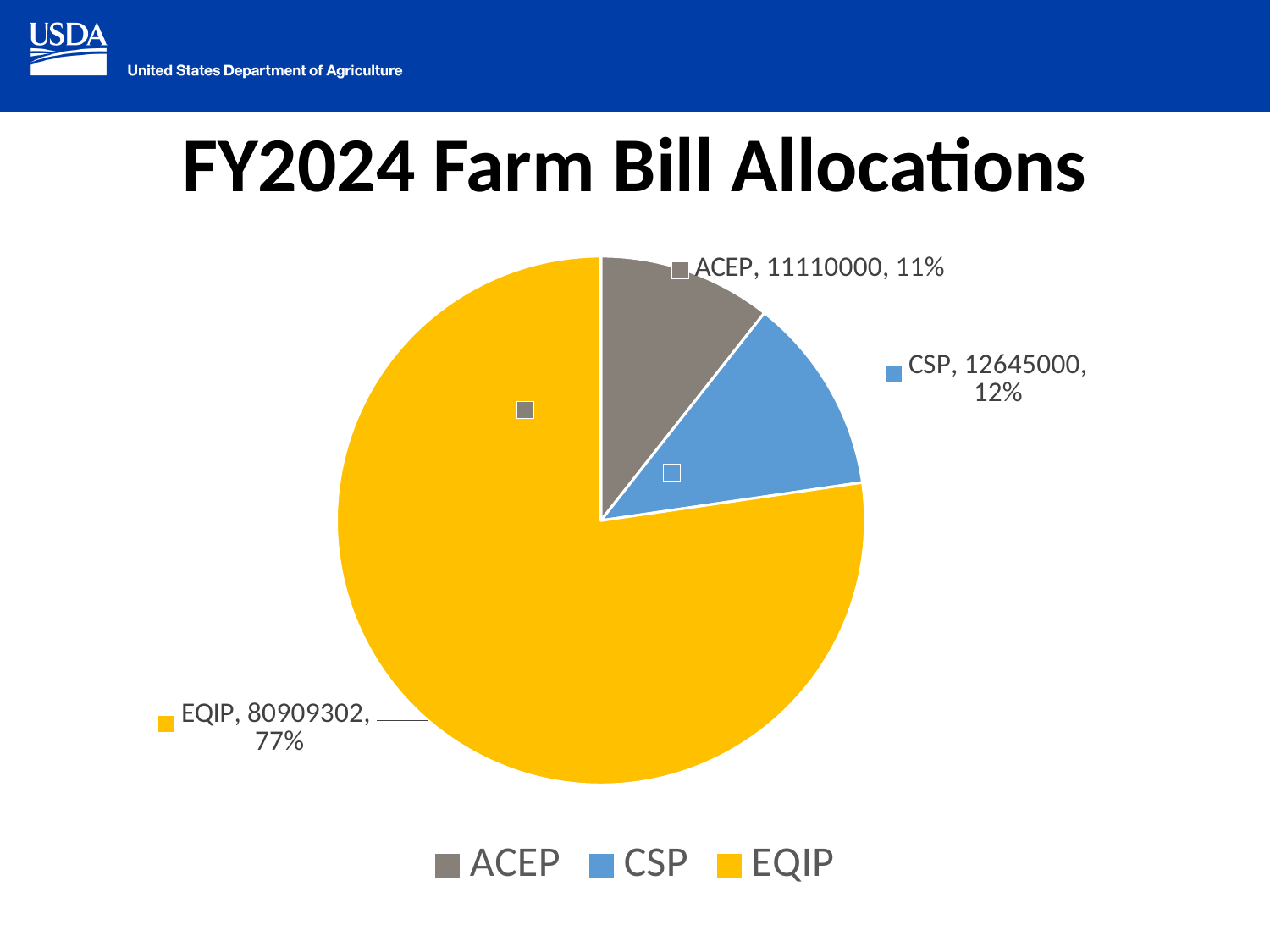
Which category has the largest slice of the pie? EQIP What is the value for ACEP? 11110000 What share of the pie does ACEP represent? 11% What type of chart is shown on the slide? Pie chart What is the value for CSP? 12645000 What share of the pie does EQIP represent? 77% How many categories are shown in the pie chart? 3 Which category has the smallest slice of the pie? ACEP Which is larger, the value for EQIP or the value for CSP? EQIP What is the value for EQIP? 80909302 What share of the pie does CSP represent? 12% What is the difference between the values for CSP and ACEP? 1535000